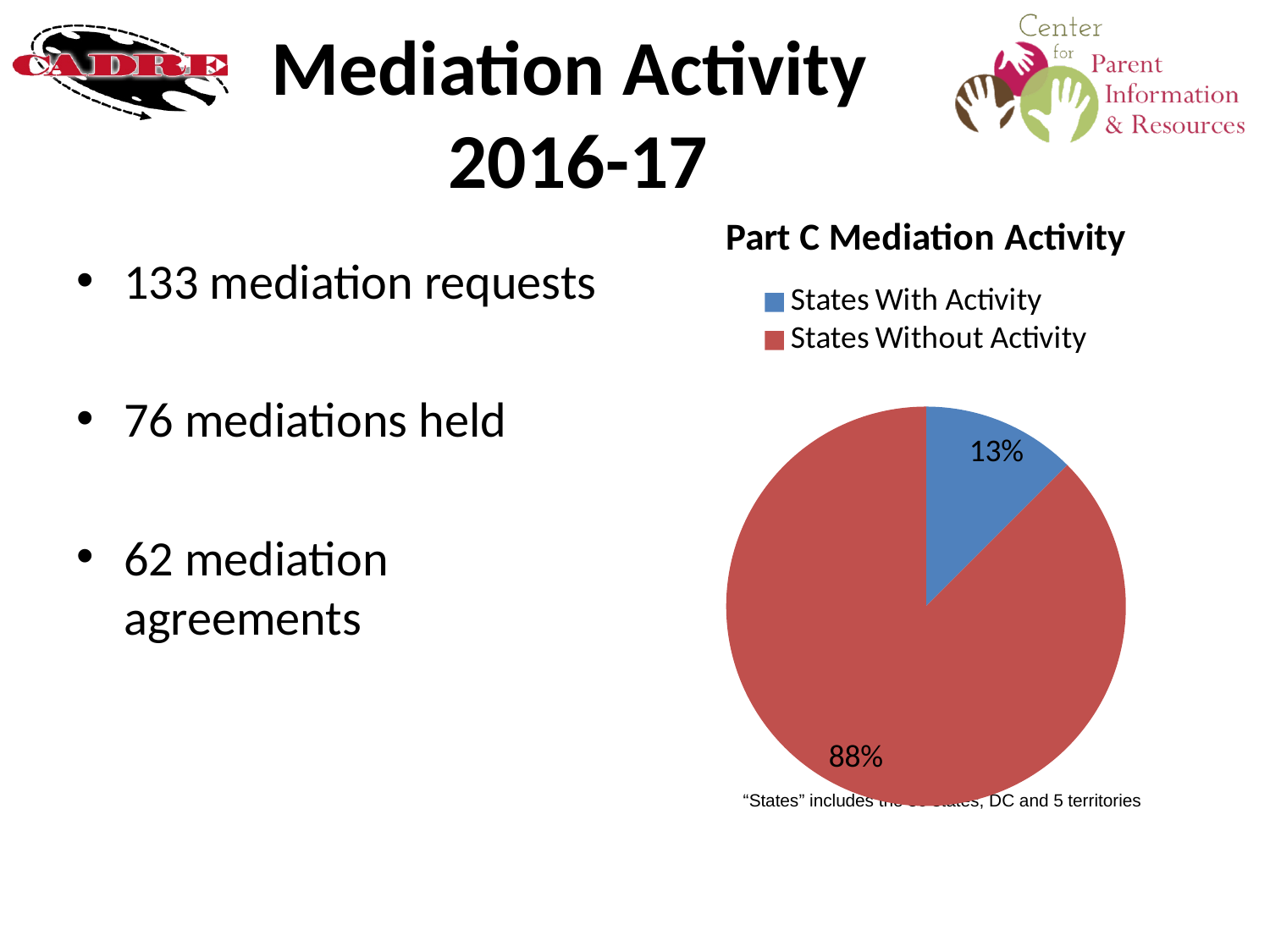
What percentage of the pie is labelled for States Without Activity? 88% Which slice of the pie is the largest? States Without Activity How many entries does the legend list? 2 What kind of chart is shown on the slide? pie chart What is the title of the chart? Part C Mediation Activity How many slices does the pie chart have? 2 What percentage of the pie is labelled for States With Activity? 13% Which slice of the pie is the smallest? States With Activity What is the difference in percentage points between the States Without Activity slice and the States With Activity slice? 75 Which is larger, the share for States With Activity or the share for States Without Activity? States Without Activity What colour is the slice for States With Activity? blue